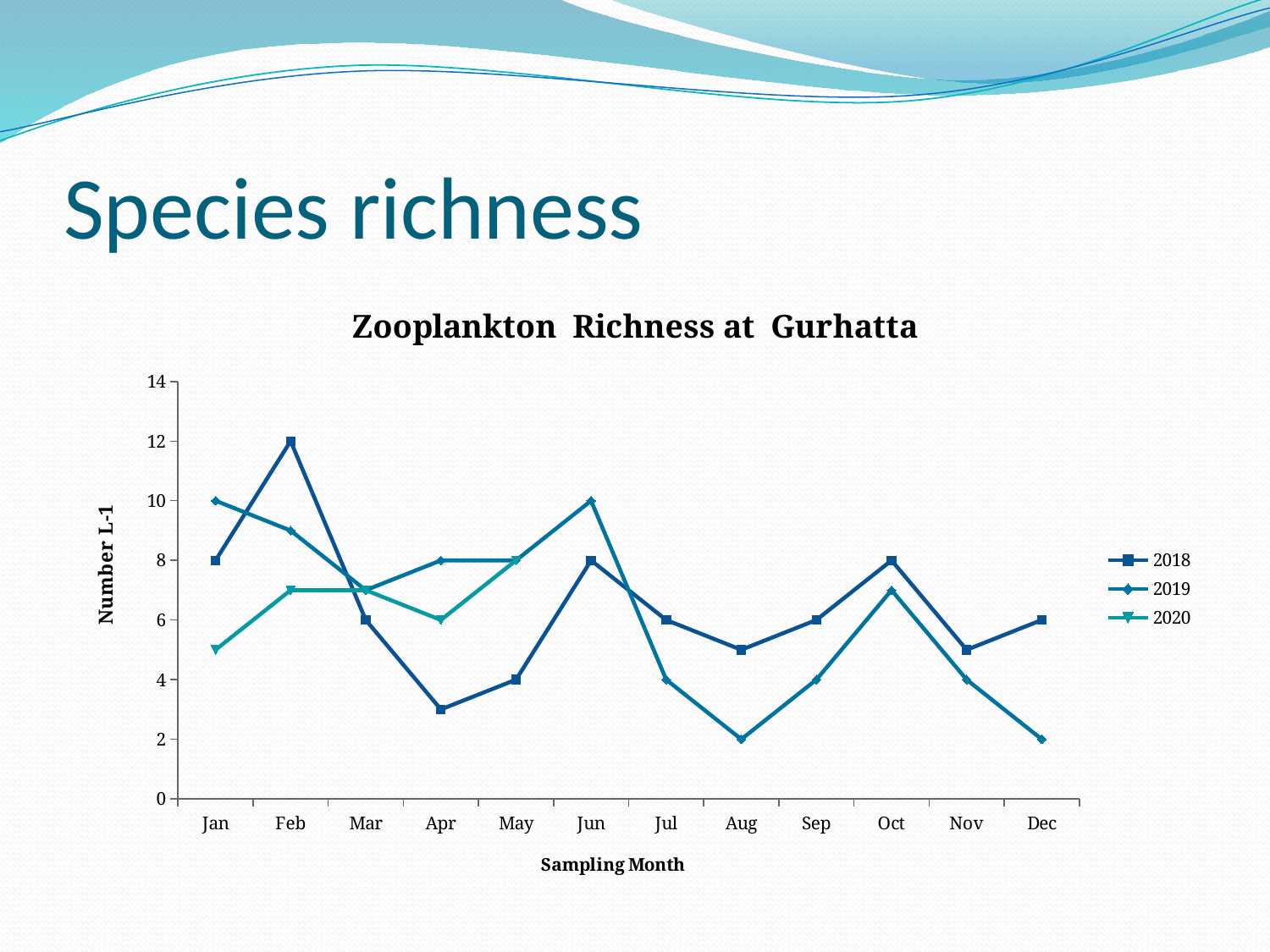
What is the 2019 value for Aug? 2 What is the 2019 value for Jan? 10 Which series has the larger value in Jan, 2018 or 2019? 2019 What is the title of the chart? Zooplankton Richness at Gurhatta What is the difference between the 2018 values for Feb and Jan? 4 How many series does the legend list? 3 What type of chart is shown on the slide? line chart In which month is the 2018 value lowest? Apr In which month is the 2018 value highest? Feb How many months are shown on the x axis? 12 What is the 2018 value for Feb? 12 Is the 2019 value for Feb greater or less than 8? greater